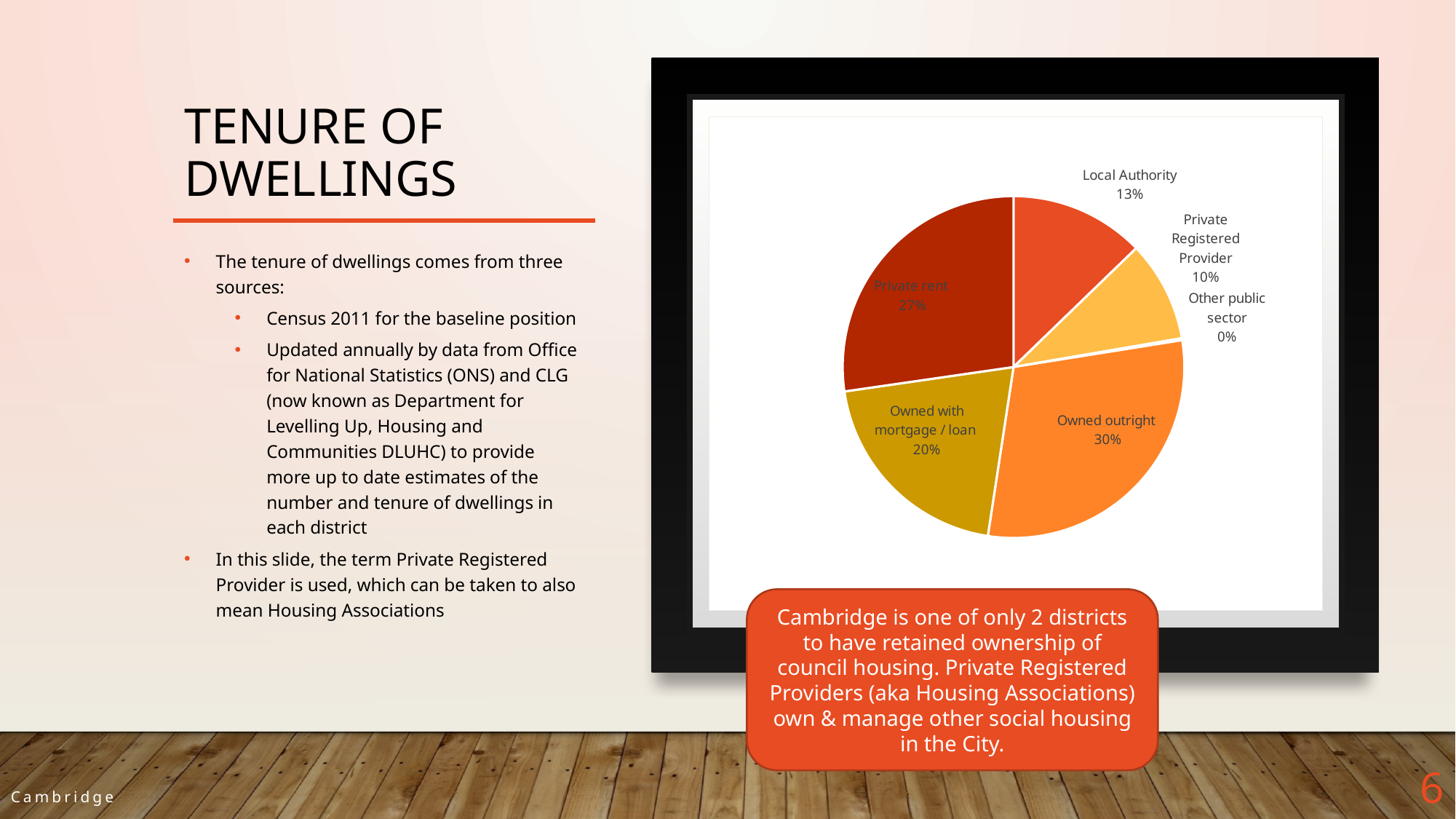
How many tenure categories are shown in the pie chart? 6 What percentage is shown for Private Registered Provider? 10% Which is larger, the share for Private rent or the share for Local Authority? Private rent What is the combined share of Local Authority and Private Registered Provider? 23% What share is shown for Owned with mortgage / loan? 20% What share is shown for Local Authority? 13% What kind of chart is shown on the slide? pie chart What is the difference in percentage points between Owned outright and Owned with mortgage / loan? 10 What percentage of dwellings is Private rent? 27% What share of dwellings is Owned outright? 30% Which tenure category has the smallest share of the pie? Other public sector Which tenure category has the largest share of the pie? Owned outright